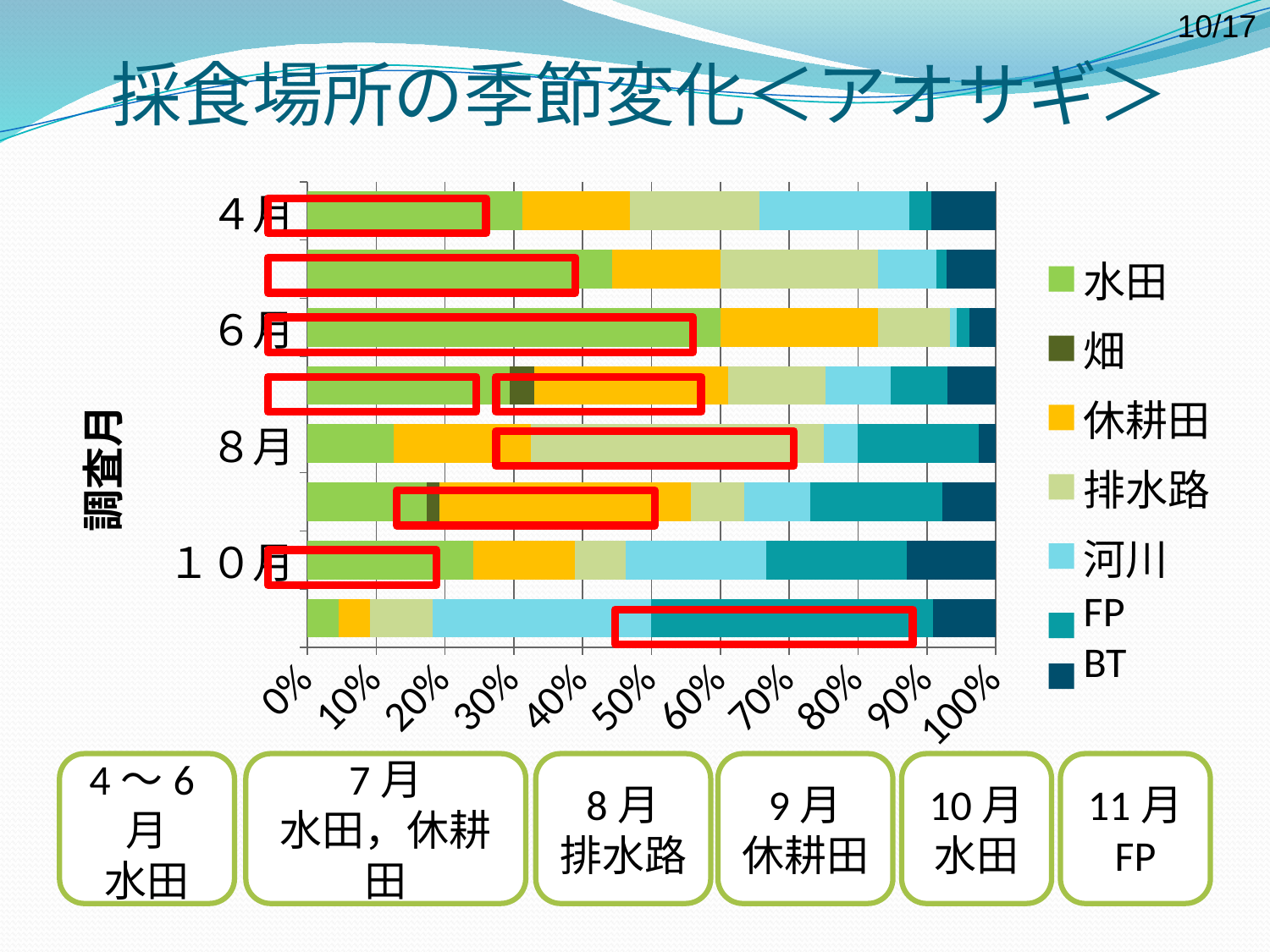
Which has the larger 水田 share, 6月 or 10月? 6月 Does the 水田 share rise or fall from 4月 to 6月? rise How many bars (months) are plotted in the chart? 8 What is the title of the vertical axis? 調査月 Is the 水田 share for 10月 greater or less than 30%? less Is the 水田 share for 4月 greater or less than 20%? greater Is the 水田 share for 6月 greater or less than 50%? greater Which month has the largest 水田 share? 6月 What kind of chart is shown on the slide? stacked bar chart How many series does the legend list? 7